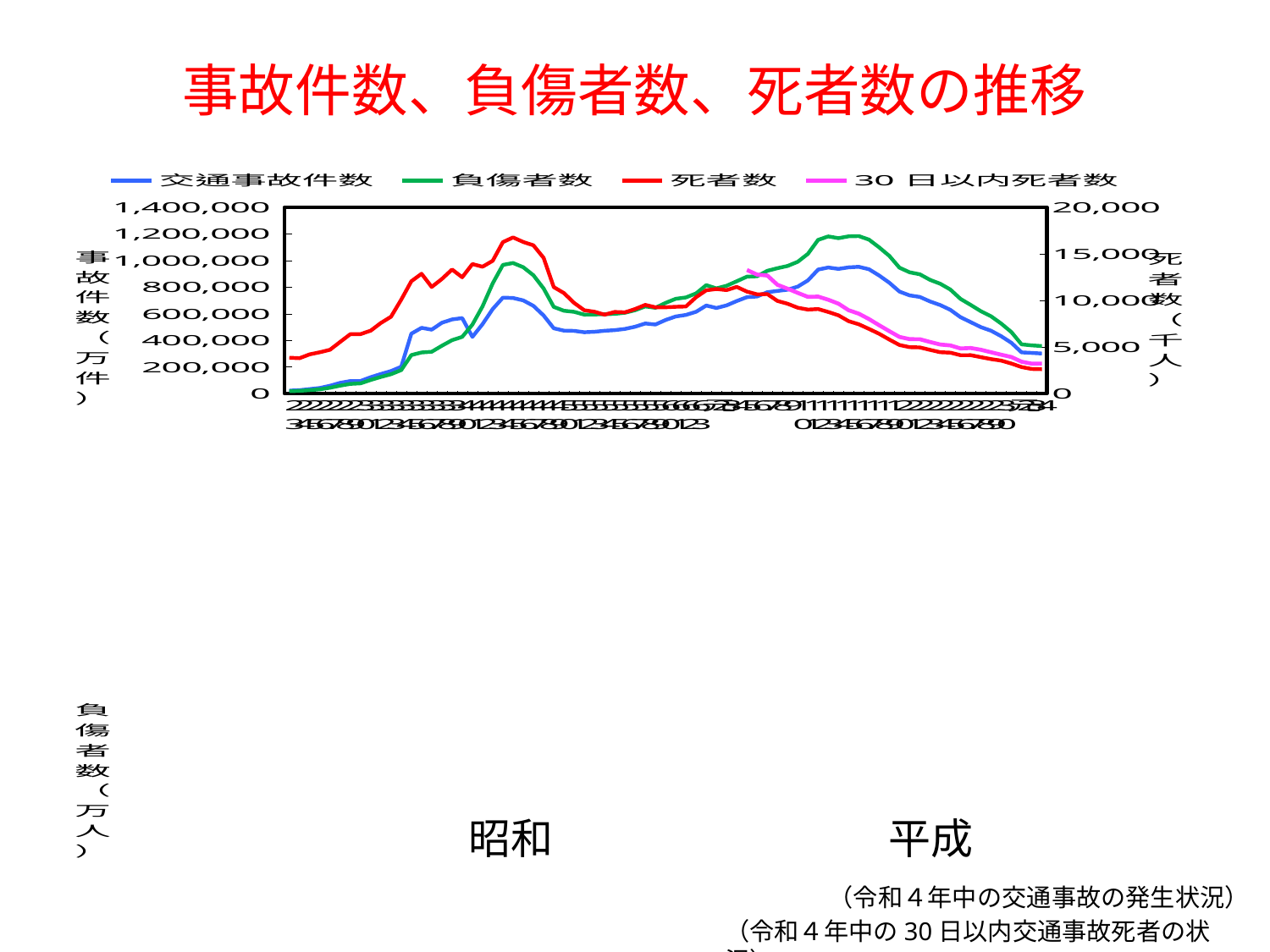
Does the 30 日以内死者数 line rise or fall from its first point to its last point? fall Is the peak value of 負傷者数 greater or less than 1,000,000? greater What kind of chart is shown on the slide? line chart Which series reaches the highest point on the left axis, 交通事故件数 or 負傷者数? 負傷者数 Is the final value of 死者数 at the right end of the chart greater or less than 5,000? less What is the title of the chart on the slide? 事故件数、負傷者数、死者数の推移 Is the peak value of 死者数 on the right axis greater or less than 15,000? greater How many series does the legend list? 4 Which series is drawn in red? 死者数 What is the highest tick value shown on the right vertical axis? 20,000 Does the 死者数 line rise or fall over the 平成 portion of the chart? fall What is the highest tick value shown on the left vertical axis? 1,400,000